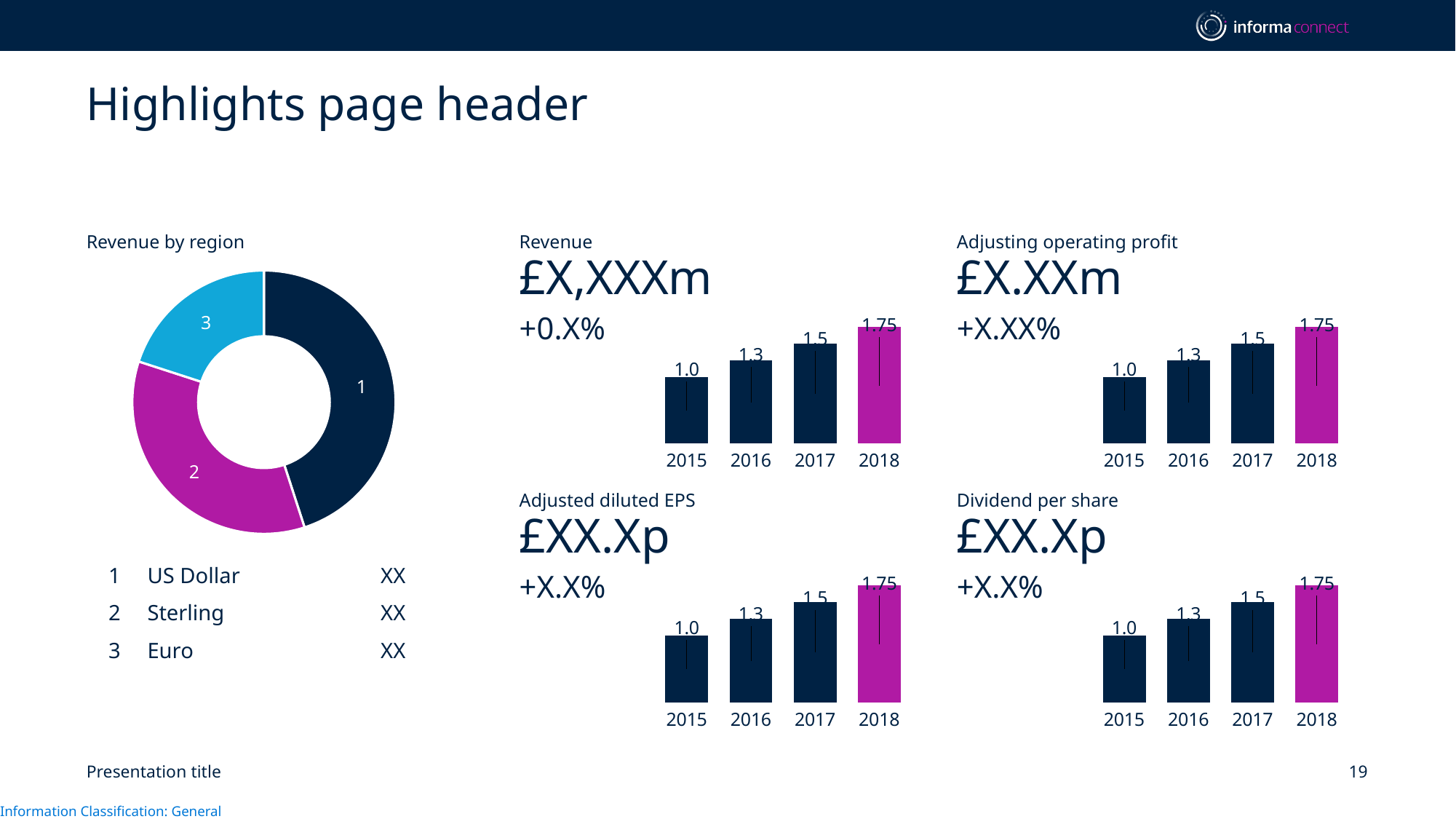
In the Adjusting operating profit bar chart, what is the value for 2016? 1.3 What kind of chart is the Revenue by region chart? donut (pie) chart In the Dividend per share bar chart, what is the value for 2017? 1.5 In the Revenue by region chart, which slice is the smallest? 3 (Euro) In the Revenue bar chart, what is the value for 2018? 1.75 How many years are shown in the Dividend per share bar chart? 4 In the Revenue bar chart, do the values rise or fall from 2015 to 2018? rise In the Adjusted diluted EPS bar chart, which is larger, the value for 2016 or the value for 2017? 2017 In the Dividend per share bar chart, which year has the lowest value? 2015 In the Revenue bar chart, which year has the highest value? 2018 In the Adjusted diluted EPS bar chart, what is the value for 2015? 1.0 In the Adjusting operating profit bar chart, what is the difference between the 2018 and 2015 values? 0.75